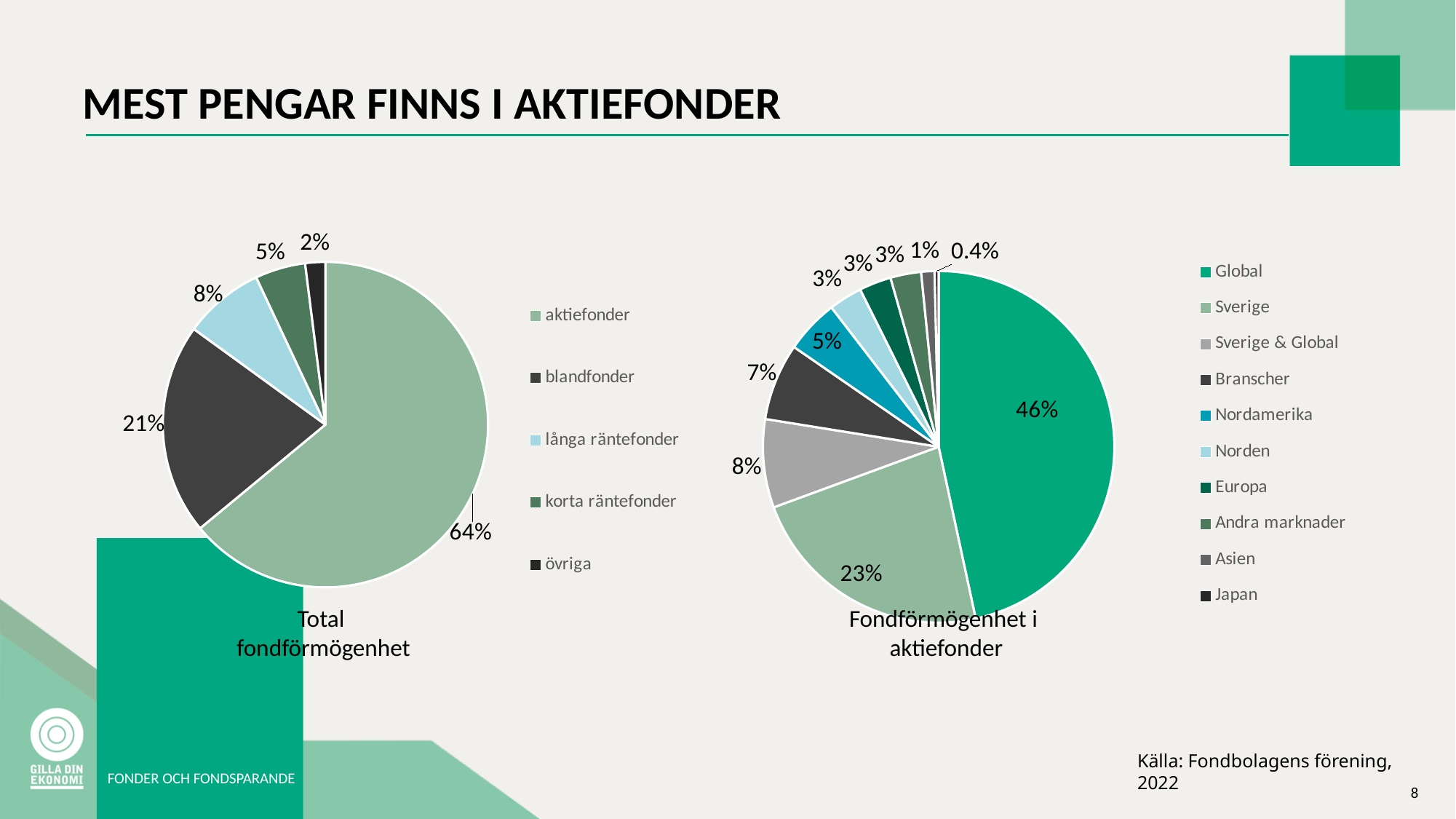
In the 'Total fondförmögenhet' chart, what share is blandfonder? 21% In the 'Fondförmögenhet i aktiefonder' chart, what share is Global? 46% In the 'Total fondförmögenhet' chart, what is the difference between aktiefonder and blandfonder? 43 percentage points In the 'Fondförmögenhet i aktiefonder' chart, which is larger, Sverige & Global or Branscher? Sverige & Global In the 'Fondförmögenhet i aktiefonder' chart, what share is Japan? 0.4% In the 'Total fondförmögenhet' chart, what share is aktiefonder? 64% In the 'Fondförmögenhet i aktiefonder' chart, what share is Sverige? 23% In the 'Fondförmögenhet i aktiefonder' chart, which category has the largest share? Global What kind of chart is 'Fondförmögenhet i aktiefonder'? Pie chart In the 'Total fondförmögenhet' chart, how many categories does the legend list? 5 In the 'Total fondförmögenhet' chart, which category has the smallest share? övriga In the 'Fondförmögenhet i aktiefonder' chart, how many categories does the legend list? 10